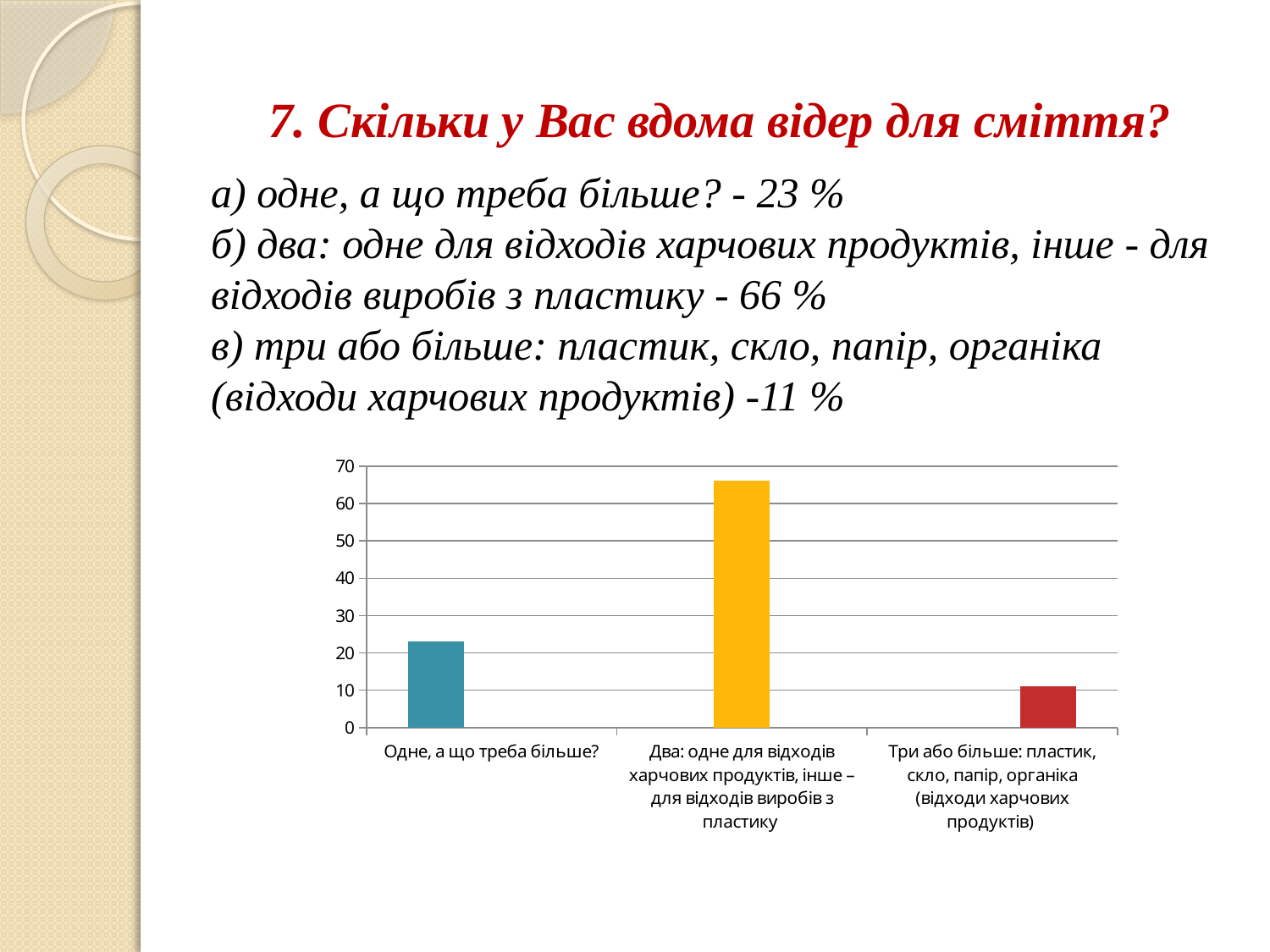
Is the value for "Два: одне для відходів харчових продуктів, інше – для відходів виробів з пластику" greater or less than 60? greater Which is larger: the value for "Одне, а що треба більше?" or the value for "Три або більше: пластик, скло, папір, органіка (відходи харчових продуктів)"? Одне, а що треба більше? How many categories does the chart show? 3 Is the value for "Одне, а що треба більше?" greater or less than 30? less Which category has the lowest bar? Три або більше: пластик, скло, папір, органіка (відходи харчових продуктів) What is the difference between the value for "Два: одне для відходів харчових продуктів, інше – для відходів виробів з пластику" and the value for "Одне, а що треба більше?"? 43 % What is the value for "Три або більше: пластик, скло, папір, органіка (відходи харчових продуктів)"? 11 % What kind of chart is shown on the slide? bar chart What is the value for "Одне, а що треба більше?"? 23 % What colour is the bar for "Два: одне для відходів харчових продуктів, інше – для відходів виробів з пластику"? yellow Which category has the highest bar? Два: одне для відходів харчових продуктів, інше – для відходів виробів з пластику What is the value for "Два: одне для відходів харчових продуктів, інше – для відходів виробів з пластику"? 66 %